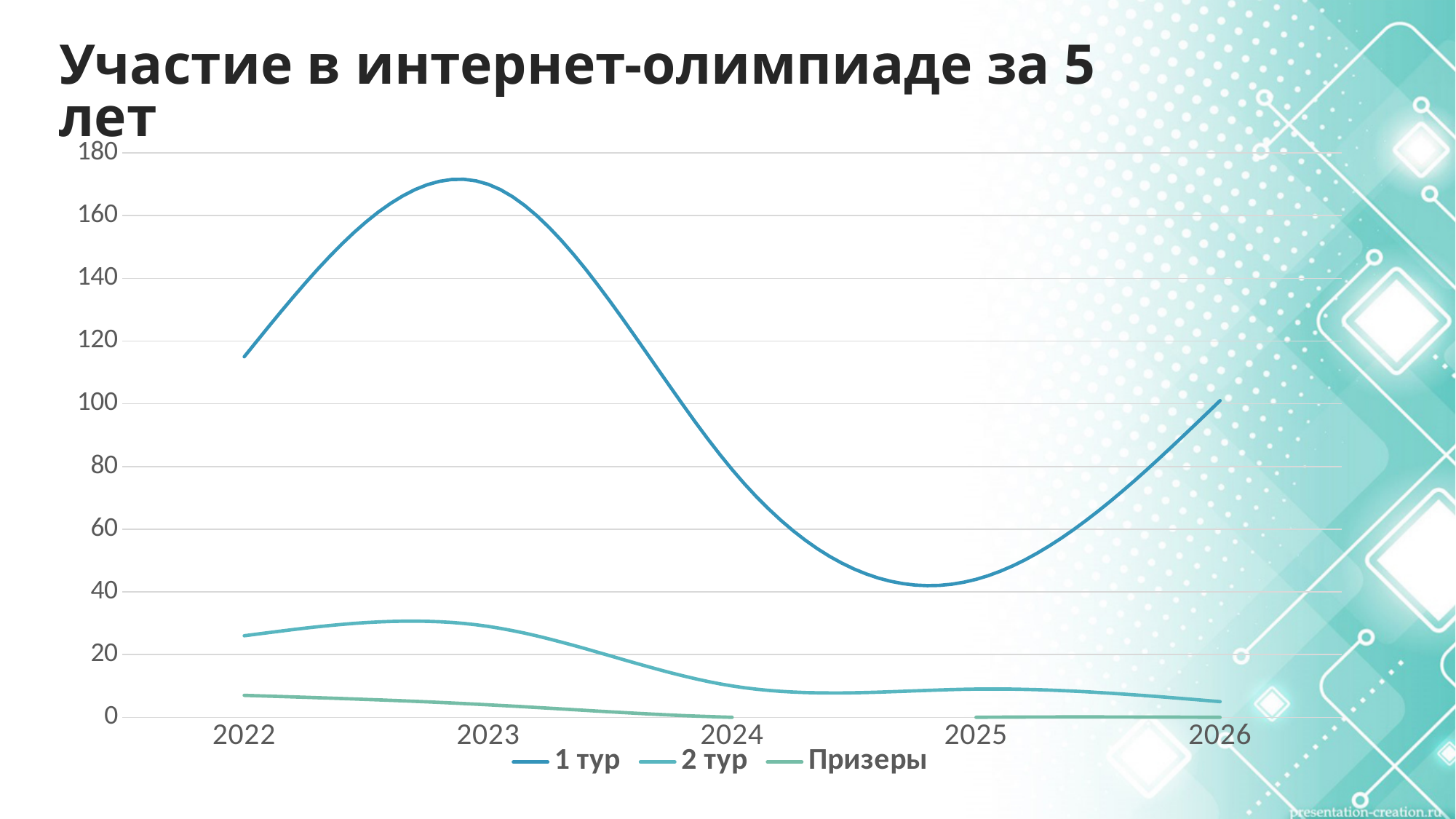
Is the value for "2 тур" in 2022 greater or less than 20? greater Is the value for "1 тур" in 2025 greater or less than 60? less What kind of chart is shown on the slide? line chart How many series does the legend list? 3 Which series has the larger value in 2023, "1 тур" or "2 тур"? 1 тур In which year does the "1 тур" series reach its lowest value? 2025 Is the value for "1 тур" in 2022 greater or less than 100? greater Does the "1 тур" series rise or fall from 2023 to 2025? fall What is the title of the slide? Участие в интернет-олимпиаде за 5 лет In which year does the "1 тур" series reach its highest value? 2023 How many years are shown on the x axis? 5